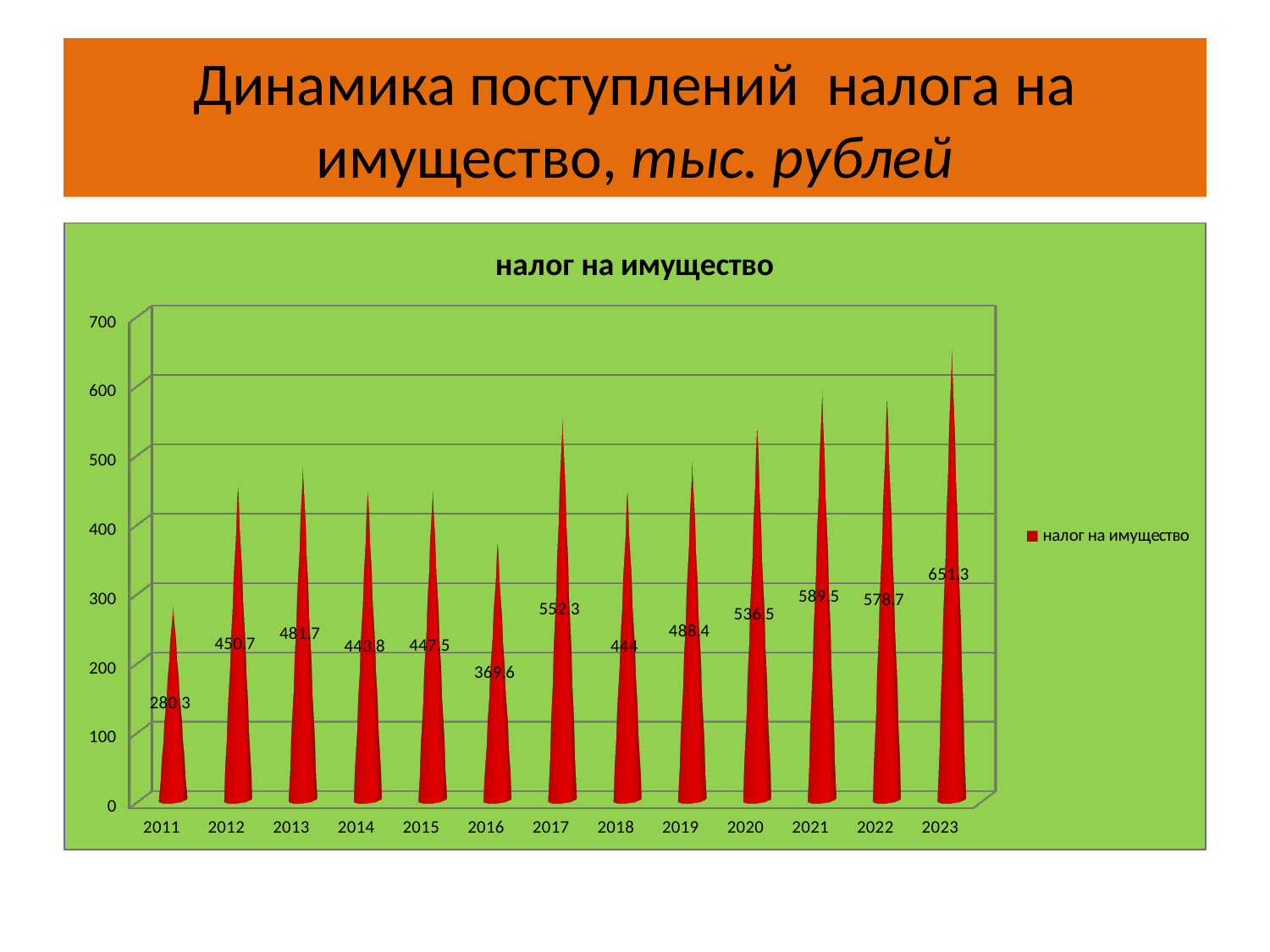
What is the difference between the values for 2023 and 2011? 371 Which year has the lowest value? 2011 How many years are shown on the x axis? 13 What is the value for 2011? 280.3 What is the value for 2023? 651.3 What is the value for 2016? 369.6 Which is larger, the value for 2021 or the value for 2022? 2021 Is the value for 2020 greater or less than 500? greater Which year has the highest value? 2023 What is the value for 2017? 552.3 What is the title of the chart? налог на имущество What kind of chart is shown on the slide? bar chart